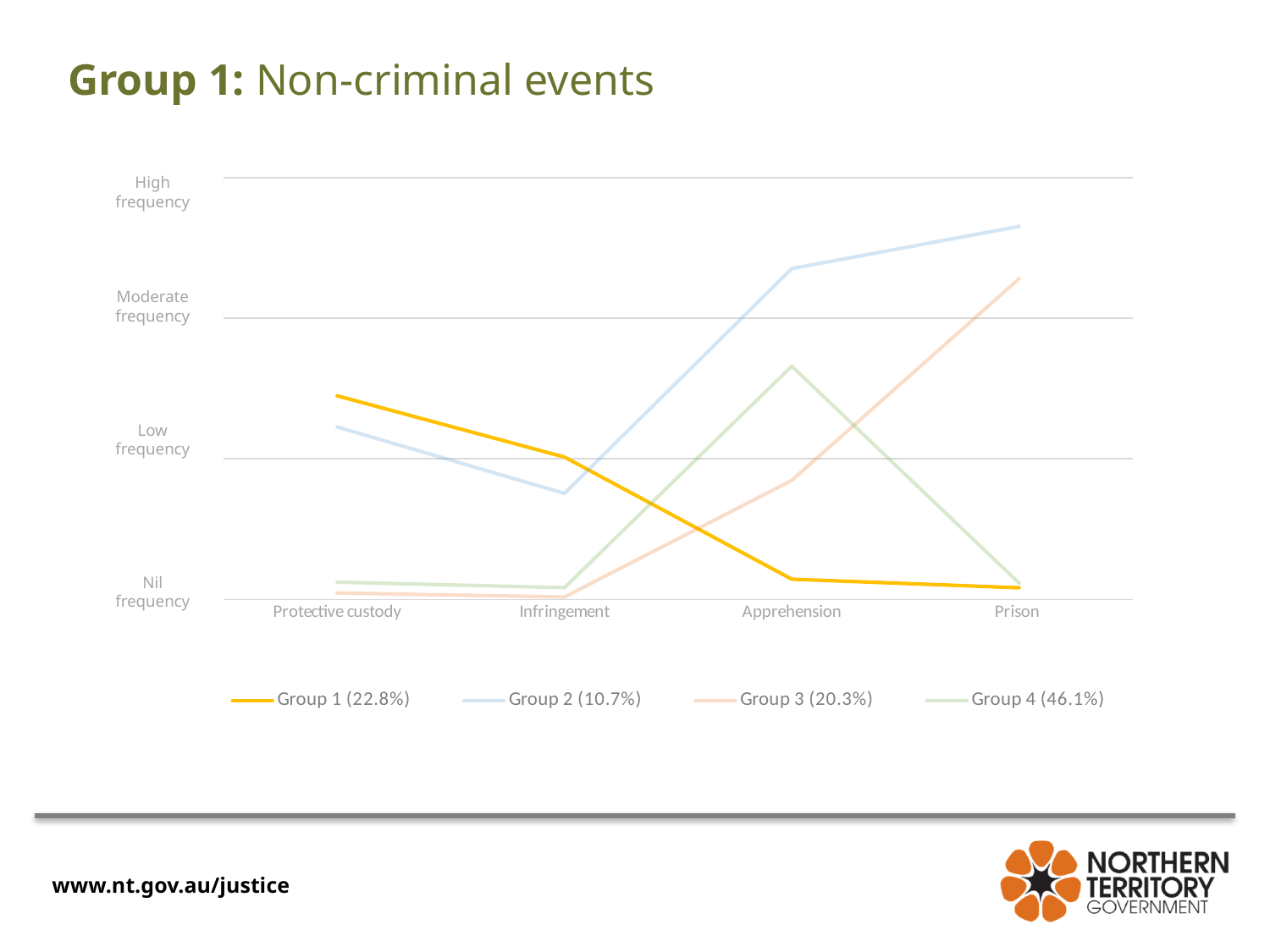
At which category does Group 4 reach its highest value? Apprehension What percentage is shown in the legend for Group 4? 46.1% Does the Group 3 line rise or fall from Infringement to Prison? Rise At Prison, which is higher: Group 2 or Group 3? Group 2 At which category does Group 2 reach its highest value? Prison What kind of chart is shown on the slide? Line chart Is the Group 2 value at Prison above or below the Moderate frequency line? Above How many series does the legend list? 4 At which category does Group 1 reach its highest value? Protective custody How many categories are shown on the x axis? 4 Does the Group 1 line rise or fall from Protective custody to Prison? Fall At Protective custody, which is higher: Group 1 or Group 4? Group 1